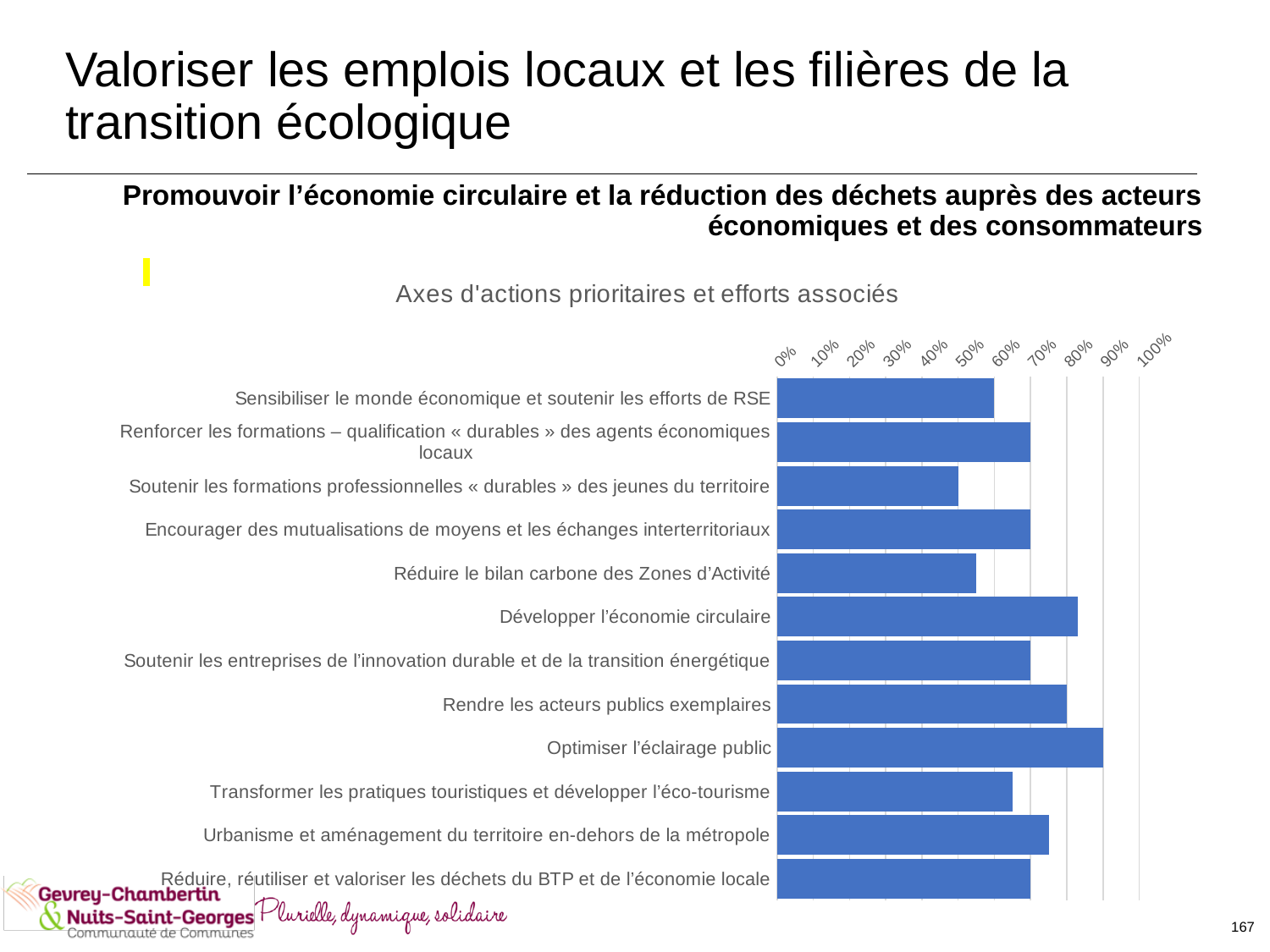
What kind of chart is shown on the slide? Bar chart Which category has the highest value in the chart? Optimiser l'éclairage public Is the value for Optimiser l'éclairage public greater or less than 80%? greater Is the value for Urbanisme et aménagement du territoire en-dehors de la métropole greater or less than 70%? greater Is the value for Soutenir les formations professionnelles « durables » des jeunes du territoire greater or less than 60%? less What colour are the bars in the chart? Blue How many categories (action axes) are plotted in the chart? 12 Which has the larger value: Développer l'économie circulaire or Urbanisme et aménagement du territoire en-dehors de la métropole? Développer l'économie circulaire Which category has the lowest value in the chart? Soutenir les formations professionnelles « durables » des jeunes du territoire Which has the larger value: Optimiser l'éclairage public or Rendre les acteurs publics exemplaires? Optimiser l'éclairage public What is the title of the chart? Axes d'actions prioritaires et efforts associés